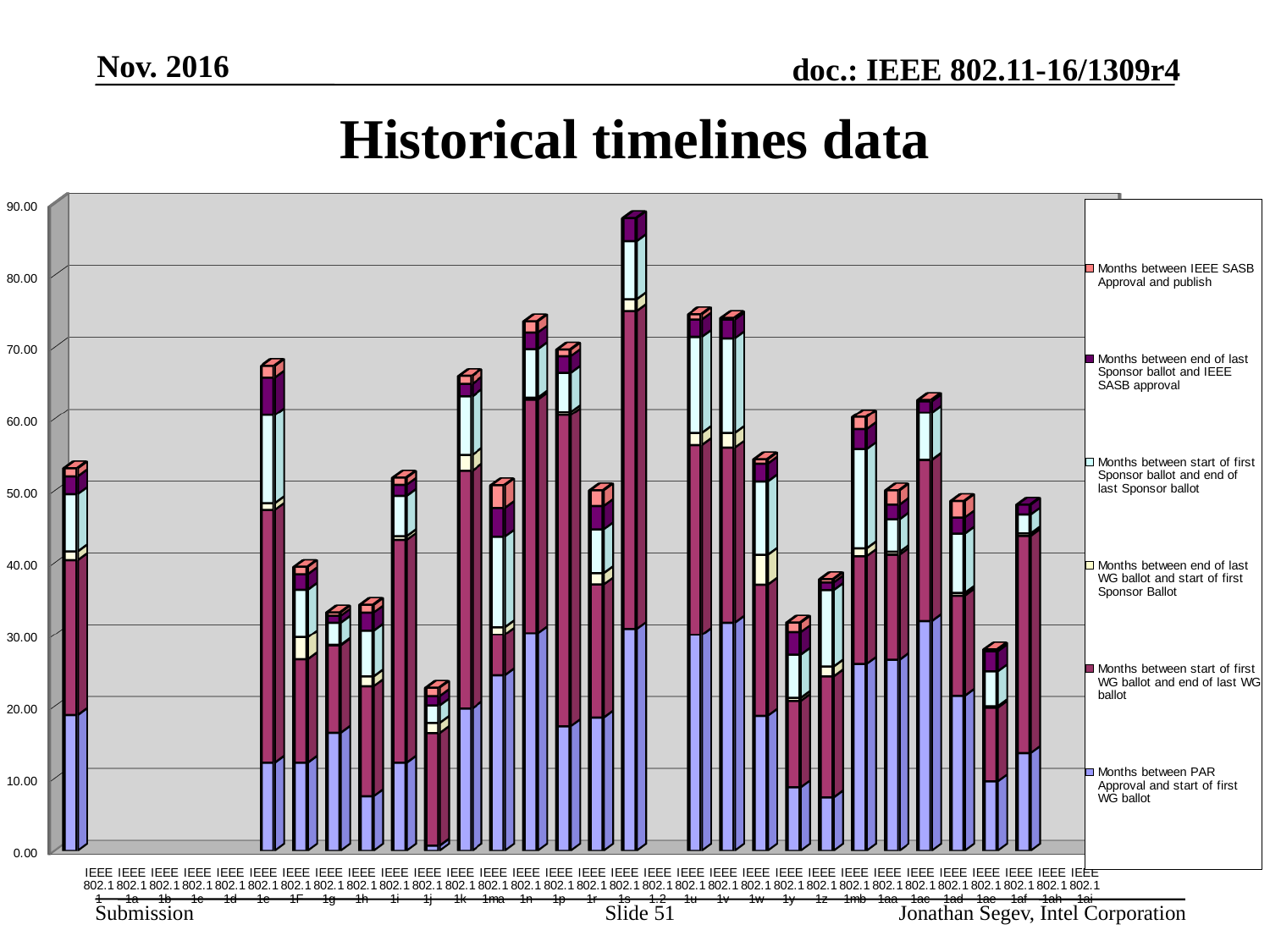
Which category has the tallest stacked bar? IEEE 802.11s What is the highest value shown on the vertical axis? 90.00 How many series does the legend list? 6 Which series is listed at the bottom of the legend? Months between PAR Approval and start of first WG ballot What is the title of the chart? Historical timelines data What kind of chart is shown on the slide? Stacked bar chart